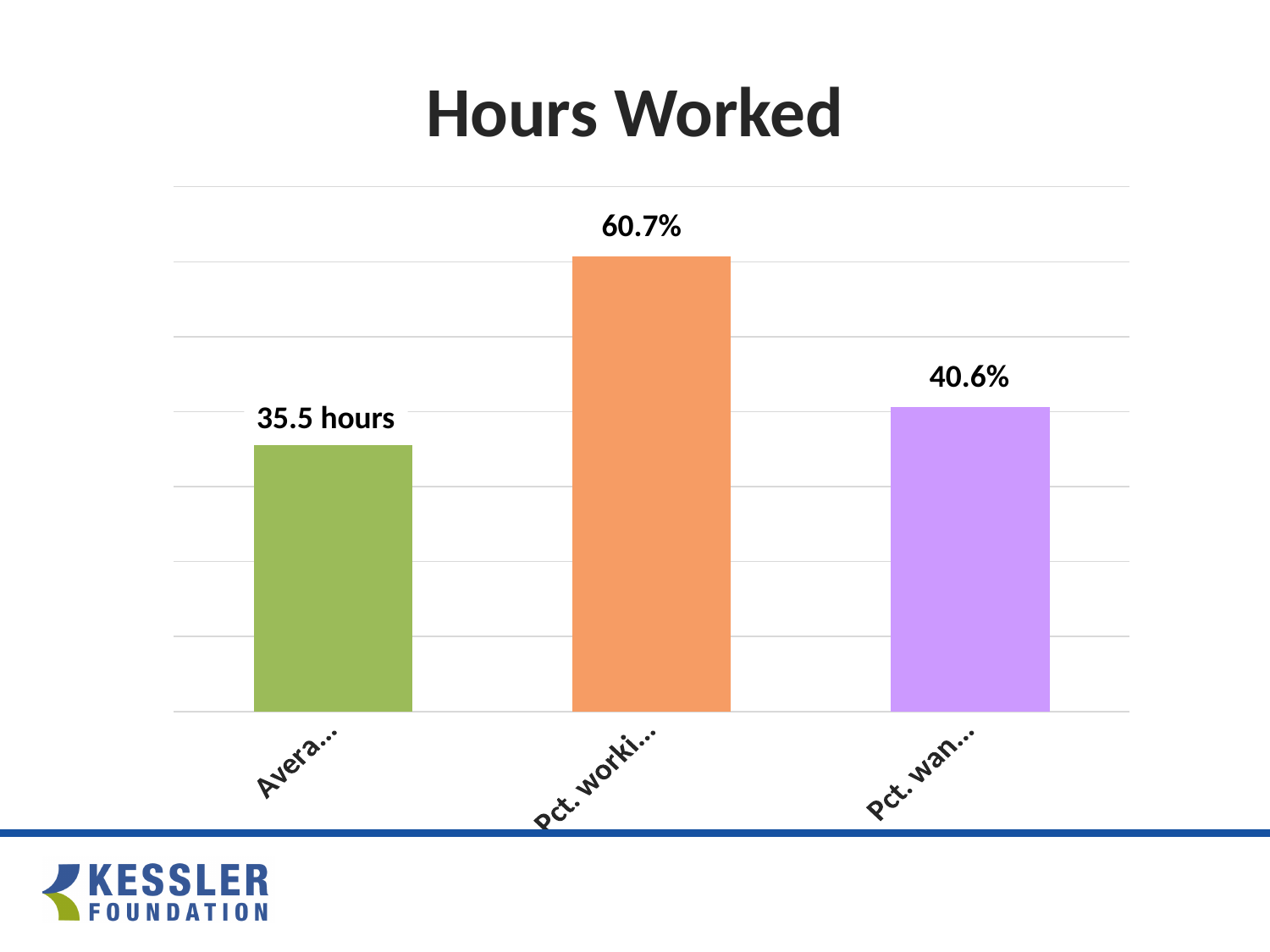
Which bar is the tallest in the chart? The middle (orange) bar What value is labelled on the green bar on the left of the chart? 35.5 hours How many bars does the chart have? 3 What is the difference between the value on the orange bar and the value on the purple bar? 20.1% Which bar is the shortest in the chart? The left (green) bar What is the title of the chart? Hours Worked What colour is the tallest bar in the chart? Orange Which bar is taller, the left bar or the right bar? The right bar What kind of chart is shown on the slide? Bar chart What value is labelled on the purple bar on the right of the chart? 40.6% Which is larger, the value on the orange bar or the value on the purple bar? The orange bar What value is labelled on the orange bar in the middle of the chart? 60.7%